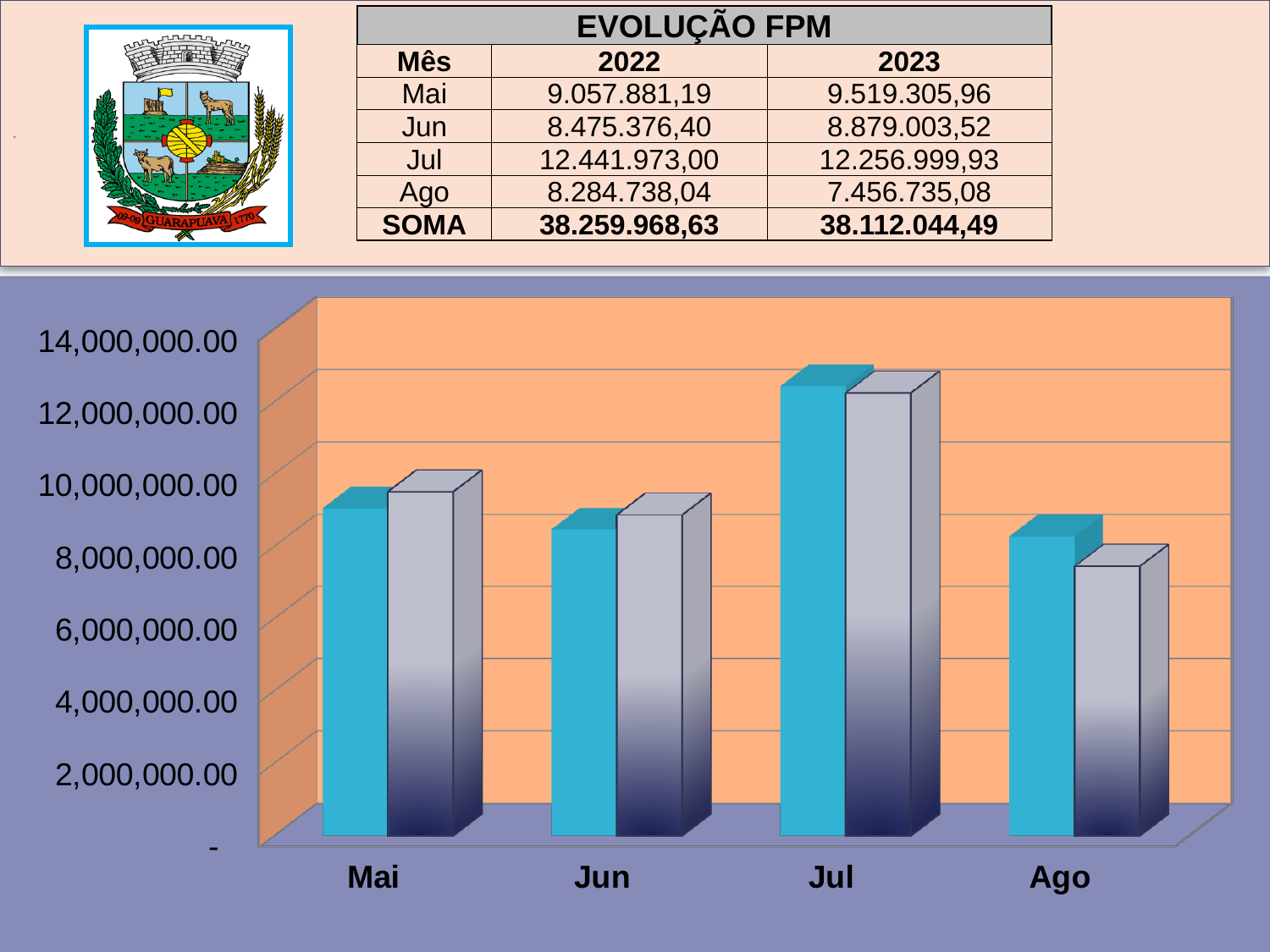
According to the table above the chart, what is the FPM value for Ago 2023? 7.456.735,08 What kind of chart is shown on the slide? bar chart How many months are shown on the x axis of the chart? 4 Which month has taller bars, Mai or Jul? Jul According to the table above the chart, what is the FPM value for Jul 2022? 12.441.973,00 Is the right-hand (grey) bar for Ago greater or less than 8,000,000.00? less Are the bars for Jul greater or less than 12,000,000.00? greater Using the table values, what is the difference between the Jul 2022 and Jul 2023 FPM values? 184.973,07 Are the bars for Jun greater or less than 10,000,000.00? less Which month has the shortest bar in the chart? Ago Which month has the tallest bars in the chart? Jul How many bars are drawn for each month in the chart? 2